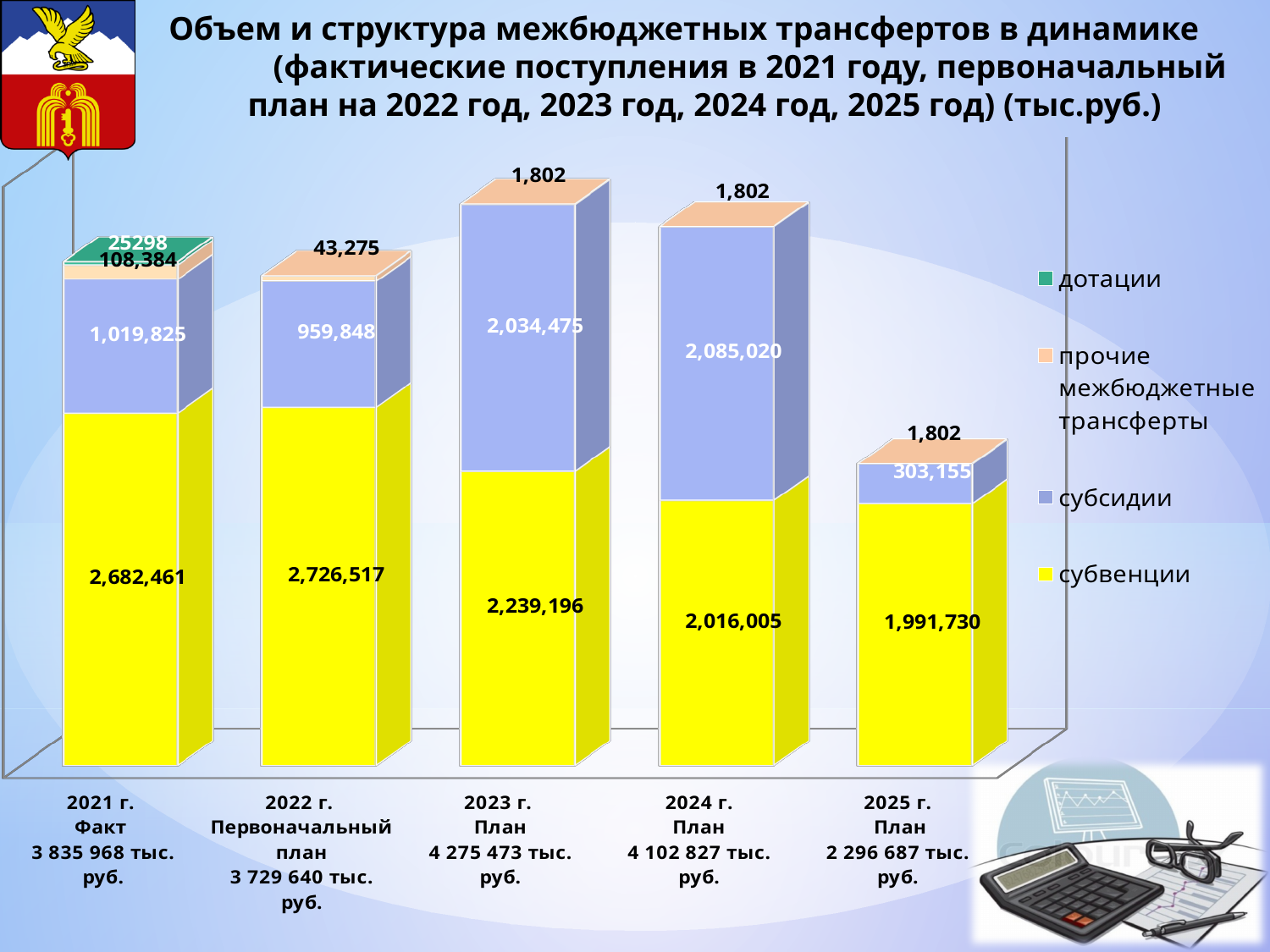
What is the value of прочие межбюджетные трансферты for 2022 г. Первоначальный план? 43,275 What kind of chart is shown on the slide? stacked bar chart Which year has the highest value of субвенции? 2022 г. How many years (categories) are shown on the x axis? 5 In 2024 г. План, which is larger: субвенции or субсидии? субсидии What is the difference between субсидии in 2024 г. and субсидии in 2023 г.? 50,545 What is the total of the stacked bar for 2025 г. План? 2 296 687 тыс. руб. What is the value of субсидии for 2024 г. План? 2,085,020 What is the value of дотации for 2021 г. Факт? 25298 Which year has the lowest value of субсидии? 2025 г. What is the value of субвенции for 2023 г. План? 2,239,196 How many series does the legend list? 4